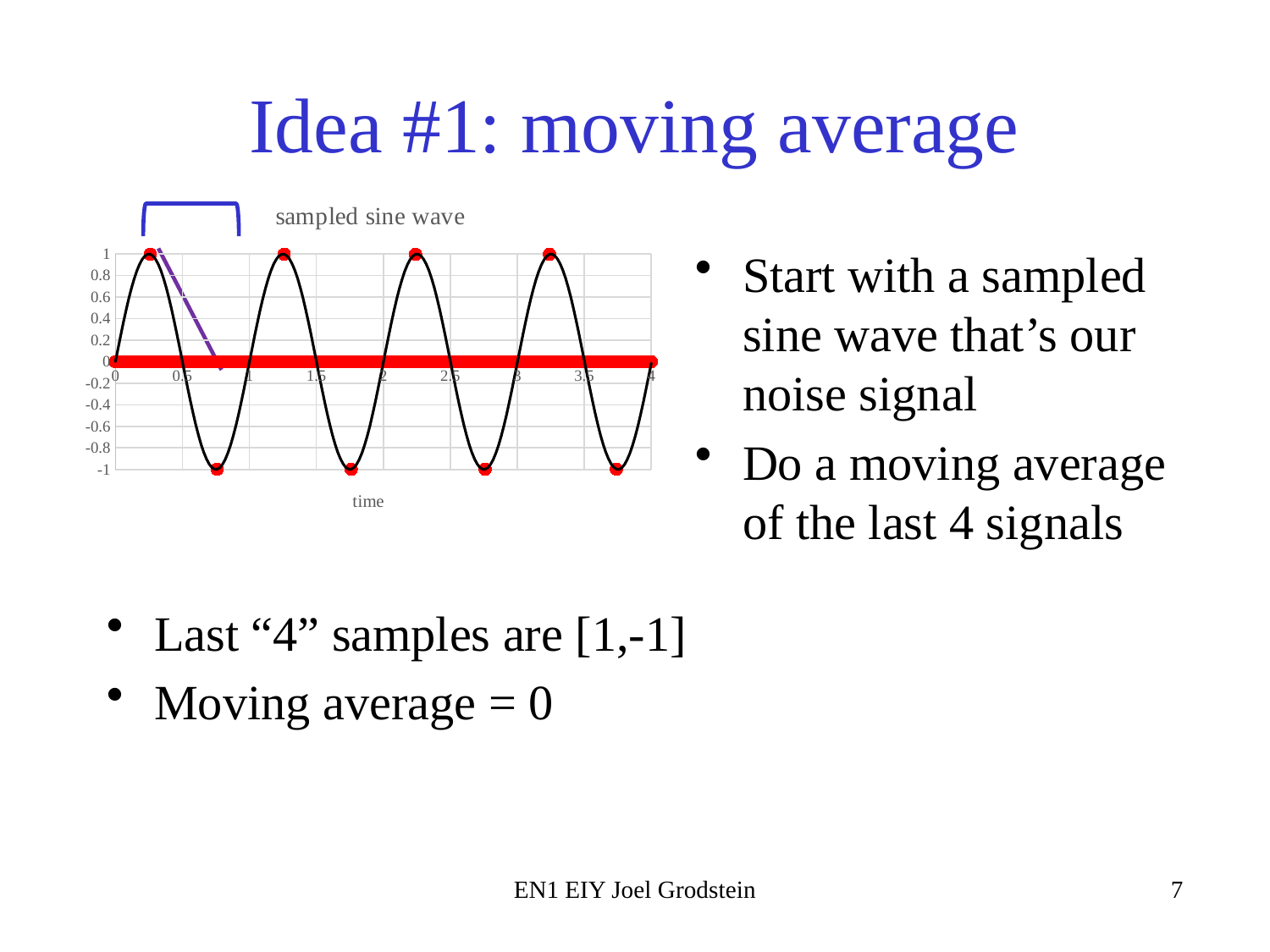
What is the label on the x axis of the chart? time What is the title of the chart? sampled sine wave What is the largest value shown on the x axis of the chart? 4 Is the value of the sine wave at time 2.75 greater or less than -0.5? less How many troughs (minimum points) does the sine wave have on the chart? 4 What kind of chart is shown on the slide? line chart What is the highest value the sine wave reaches on the chart? 1 How many peaks (maximum points) does the sine wave have on the chart? 4 Is the value of the sine wave at time 0.75 greater or less than 0? less What is the lowest value the sine wave reaches on the chart? -1 Is the value of the sine wave at time 1.25 greater or less than 0.5? greater What is the difference between the highest and lowest values of the sine wave on the chart? 2